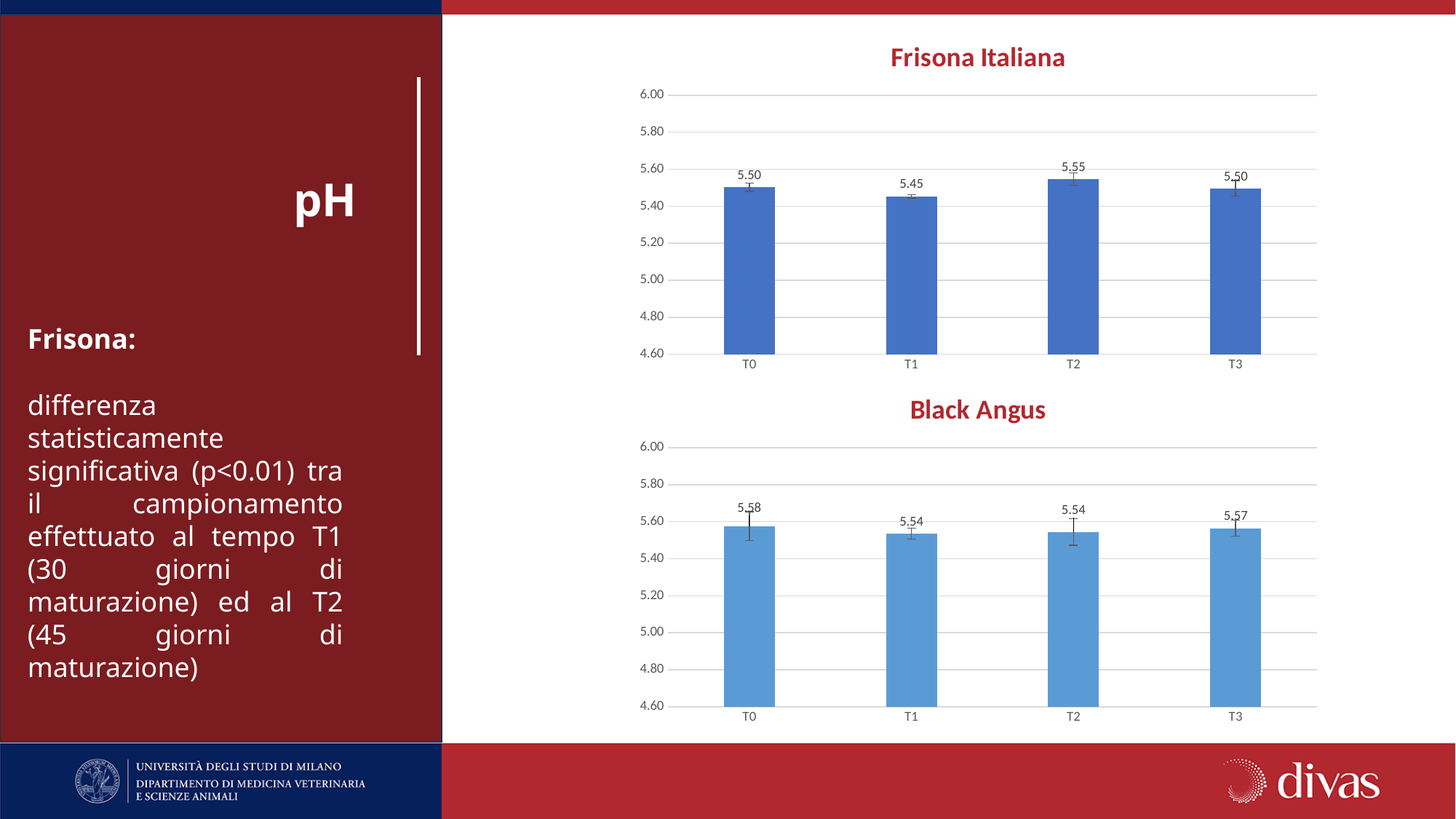
In the Black Angus chart, what is the difference between the pH values at T0 and T2? 0.04 In the Frisona Italiana chart, what is the difference between the pH values at T2 and T1? 0.10 In the Frisona Italiana chart, what is the pH value at T2? 5.55 In the Black Angus chart, what is the pH value at T3? 5.57 In the Black Angus chart, which time point has the highest pH value? T0 In the Frisona Italiana chart, which time point has the lowest pH value? T1 In the Frisona Italiana chart, what is the pH value at T1? 5.45 In the Black Angus chart, what is the pH value at T0? 5.58 What type of chart is the Frisona Italiana chart? Bar chart In the Frisona Italiana chart, which time point has the highest pH value? T2 How many time points are shown in the Black Angus chart? 4 In the Frisona Italiana chart, is the pH value at T2 greater or less than 5.40? greater